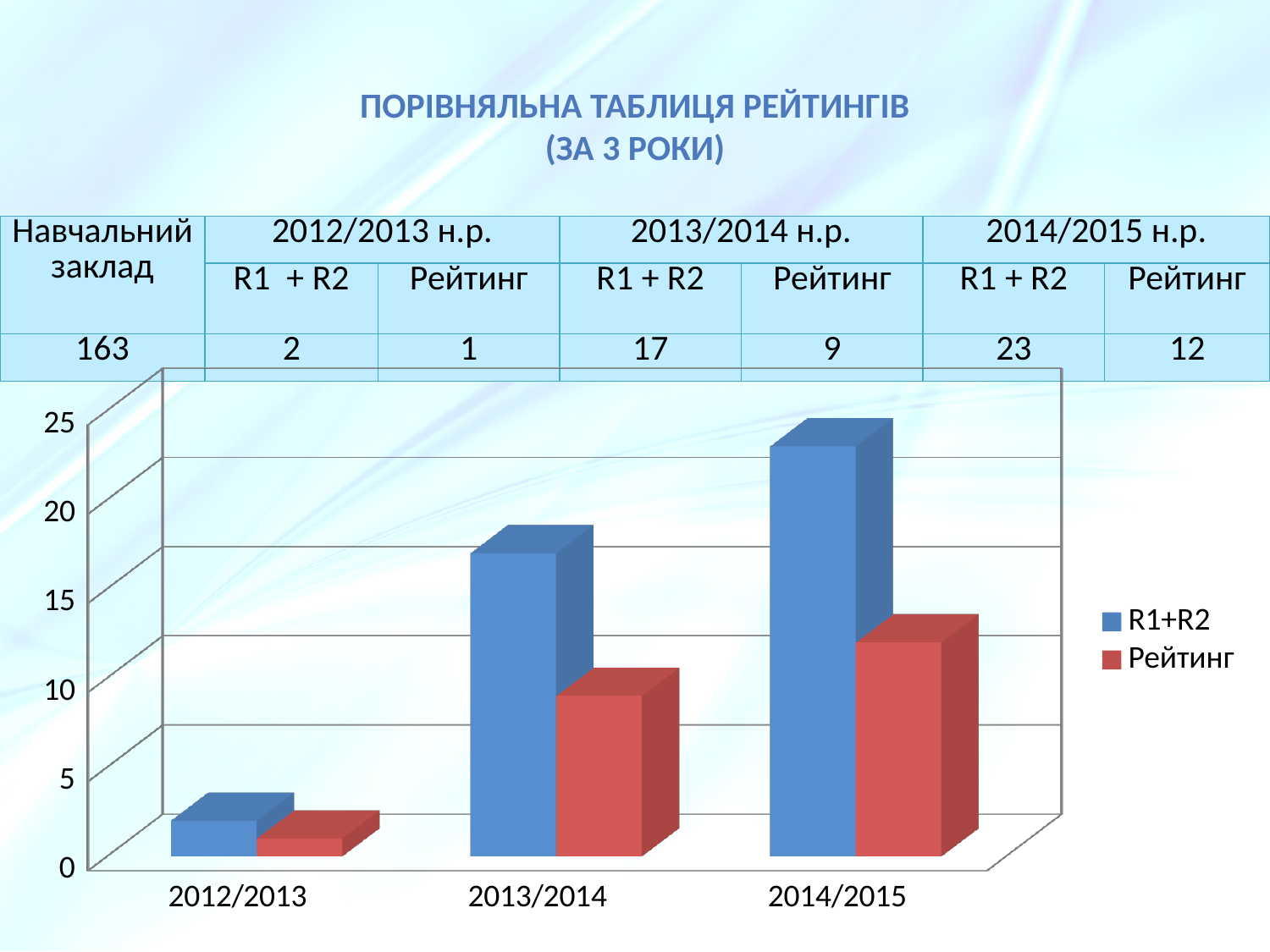
What is the R1+R2 value for 2014/2015? 23 What kind of chart is shown on the slide? bar chart How many series does the chart legend list? 2 Which year has the lowest Рейтинг value? 2012/2013 Do the R1+R2 values rise or fall from 2012/2013 to 2014/2015? rise Which is larger for 2013/2014, R1+R2 or Рейтинг? R1+R2 What is the difference between the R1+R2 value and the Рейтинг value for 2014/2015? 11 What is the R1+R2 value for 2012/2013? 2 Which year has the highest R1+R2 value? 2014/2015 What is the Рейтинг value for 2013/2014? 9 How many year categories are shown on the x axis of the chart? 3 Which colour represents the Рейтинг series in the chart? red